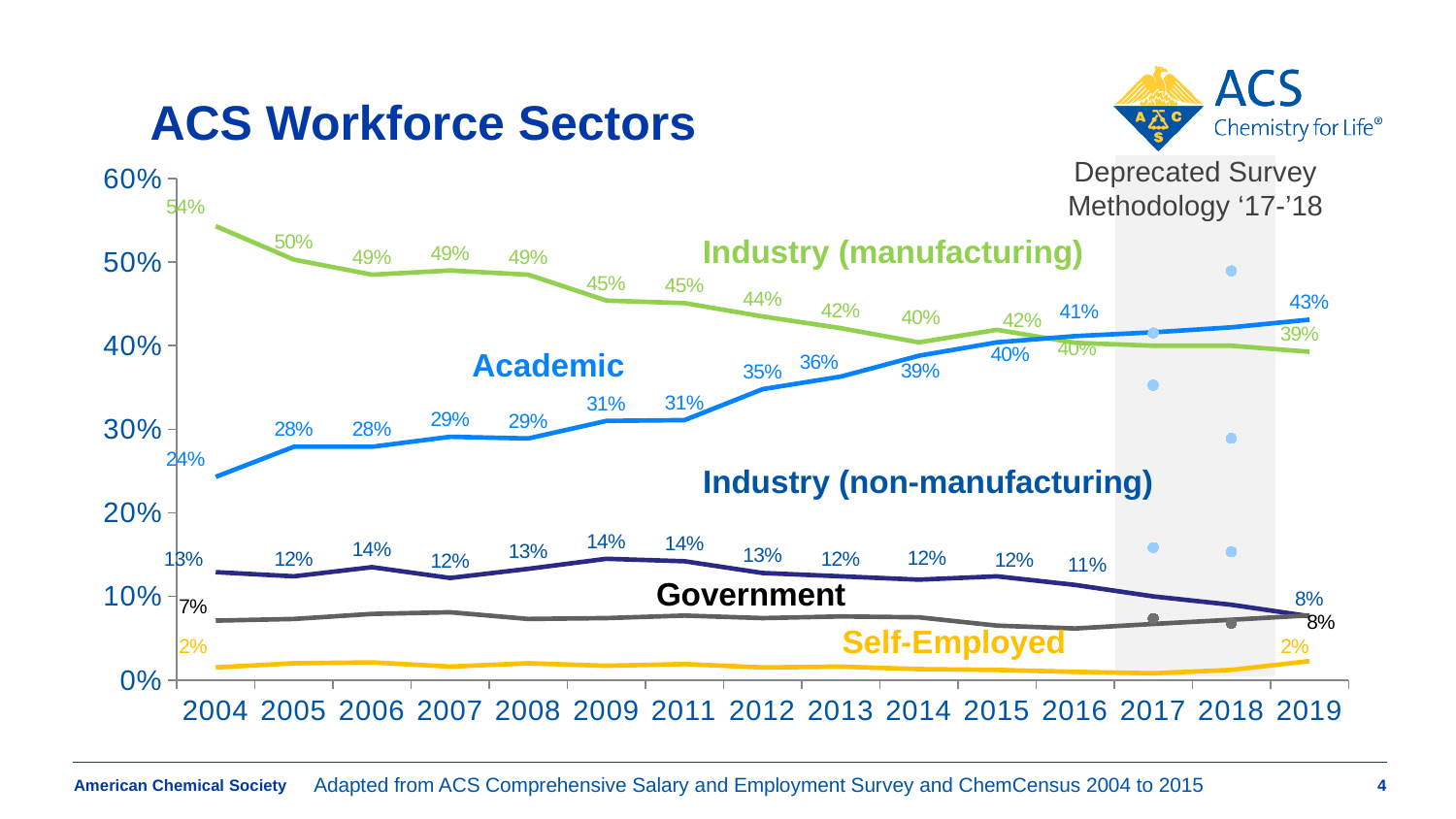
In 2019, which is larger: the Academic share or the Industry (manufacturing) share? Academic What kind of chart is shown on the slide? Line chart What was the Government share in 2004? 7% Does the Academic line rise or fall from 2004 to 2019? Rises By how many percentage points did the Industry (manufacturing) share change between 2004 (54%) and 2019 (39%)? 15 percentage points What was the Industry (manufacturing) share in 2019? 39% What was the Industry (manufacturing) share in 2004? 54% What does the shaded region over 2017 and 2018 indicate? Deprecated Survey Methodology '17-'18 Does the Industry (manufacturing) line rise or fall from 2004 to 2019? Falls What was the Academic share in 2004? 24% What was the Self-Employed share in 2019? 2% What was the Industry (non-manufacturing) share in 2016? 11%